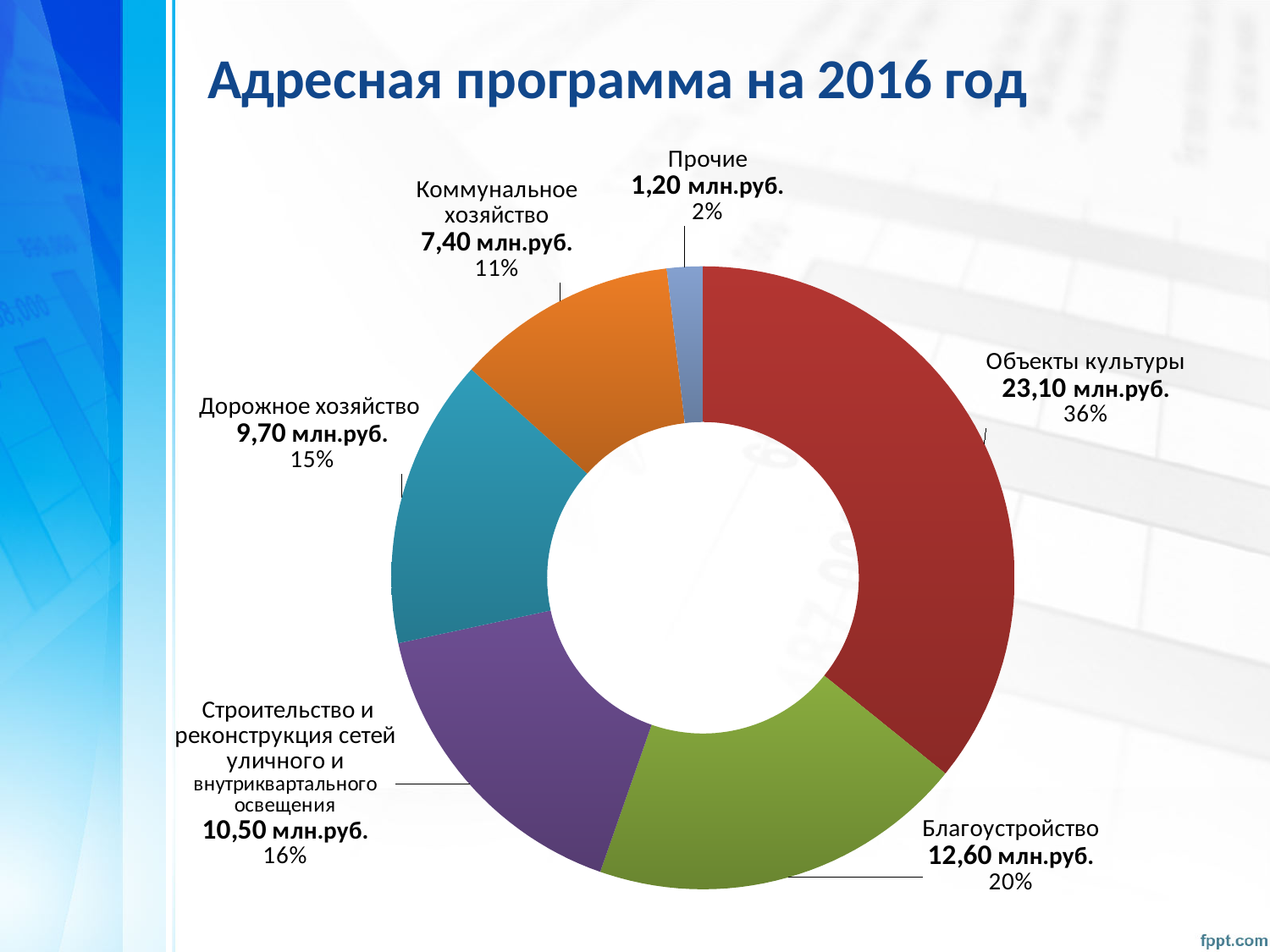
What type of chart is shown on the slide? doughnut chart What share of the chart does Благоустройство represent? 20% What is the value for Дорожное хозяйство? 9,70 млн.руб. What is the value for Коммунальное хозяйство? 7,40 млн.руб. Which category has the largest value? Объекты культуры Which category has the smallest value? Прочие What is the difference between the values for Объекты культуры and Благоустройство? 10,50 млн.руб. What is the title of the slide? Адресная программа на 2016 год What is the value for Объекты культуры? 23,10 млн.руб. How many categories are shown in the chart? 6 Which is larger: Дорожное хозяйство or Коммунальное хозяйство? Дорожное хозяйство What share of the chart does Прочие represent? 2%